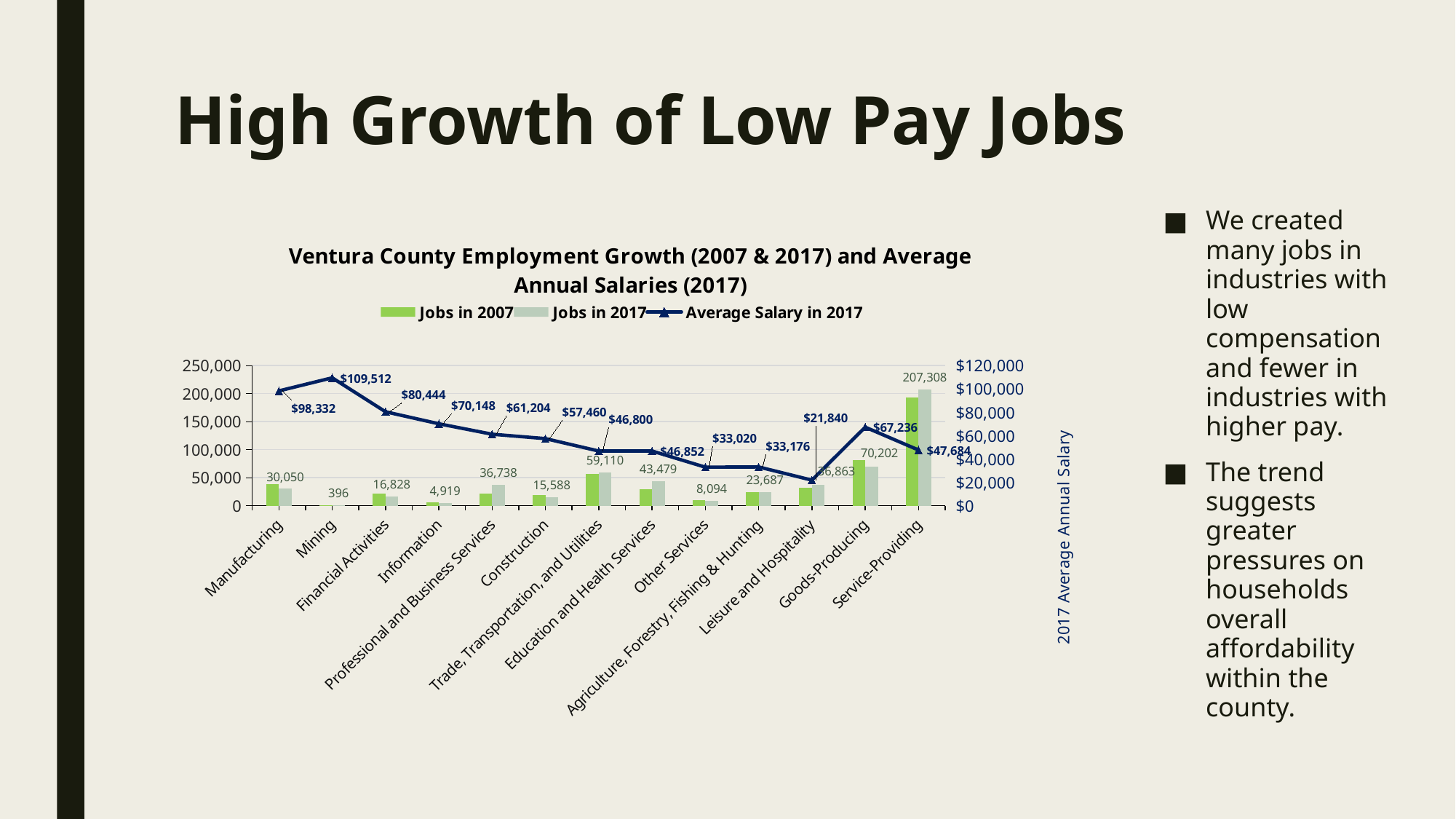
Does the Average Salary in 2017 line generally rise or fall from Mining to Leisure and Hospitality? fall How many series does the chart legend list? 3 Which industry has the highest Average Salary in 2017? Mining What is the number of Jobs in 2017 for Service-Providing? 207,308 What is the Average Salary in 2017 for Leisure and Hospitality? $21,840 How many industry categories are shown on the x axis? 13 What is the difference between the Average Salary in 2017 for Mining and for Leisure and Hospitality? $87,672 Which industry has the lowest number of Jobs in 2017? Mining Is the value for Jobs in 2007 for Goods-Producing greater or less than 50,000? greater Which has more Jobs in 2017, Goods-Producing or Service-Providing? Service-Providing What is the title of the chart? Ventura County Employment Growth (2007 & 2017) and Average Annual Salaries (2017) What is the Average Salary in 2017 for Mining? $109,512